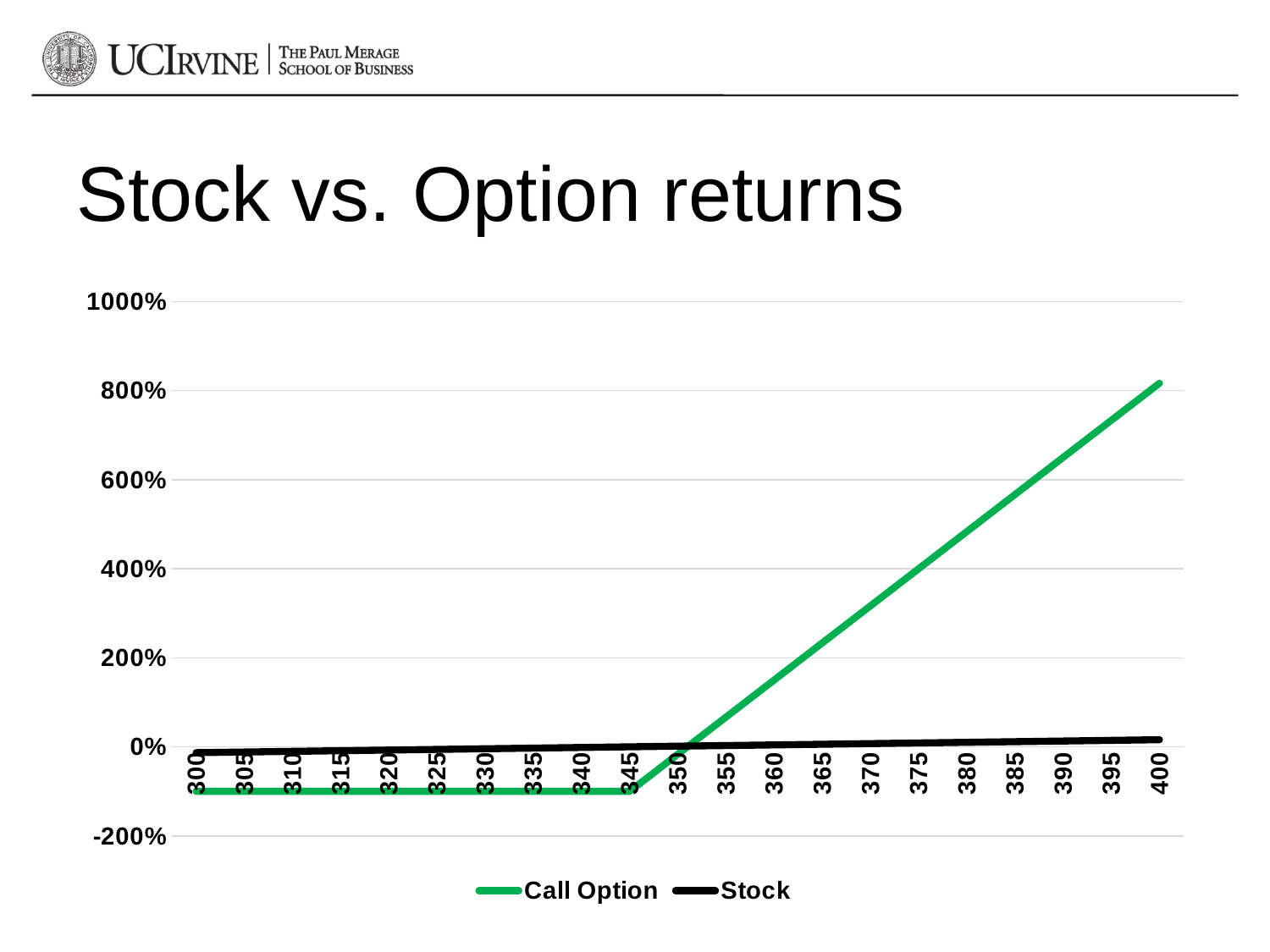
Is the Call Option value at 300 greater or less than 0%? less Which series is drawn in green? Call Option At 300, which series has the lower value, Call Option or Stock? Call Option Is the Call Option value at 400 greater or less than 600%? greater At 400, which series has the higher value, Call Option or Stock? Call Option How many points are labelled along the x axis? 21 At which x-axis value does the Call Option series reach its highest point? 400 What are the two series named in the legend? Call Option and Stock How many series does the legend list? 2 Is the Call Option value at 380 greater or less than 400%? greater What kind of chart is shown on the slide? line chart